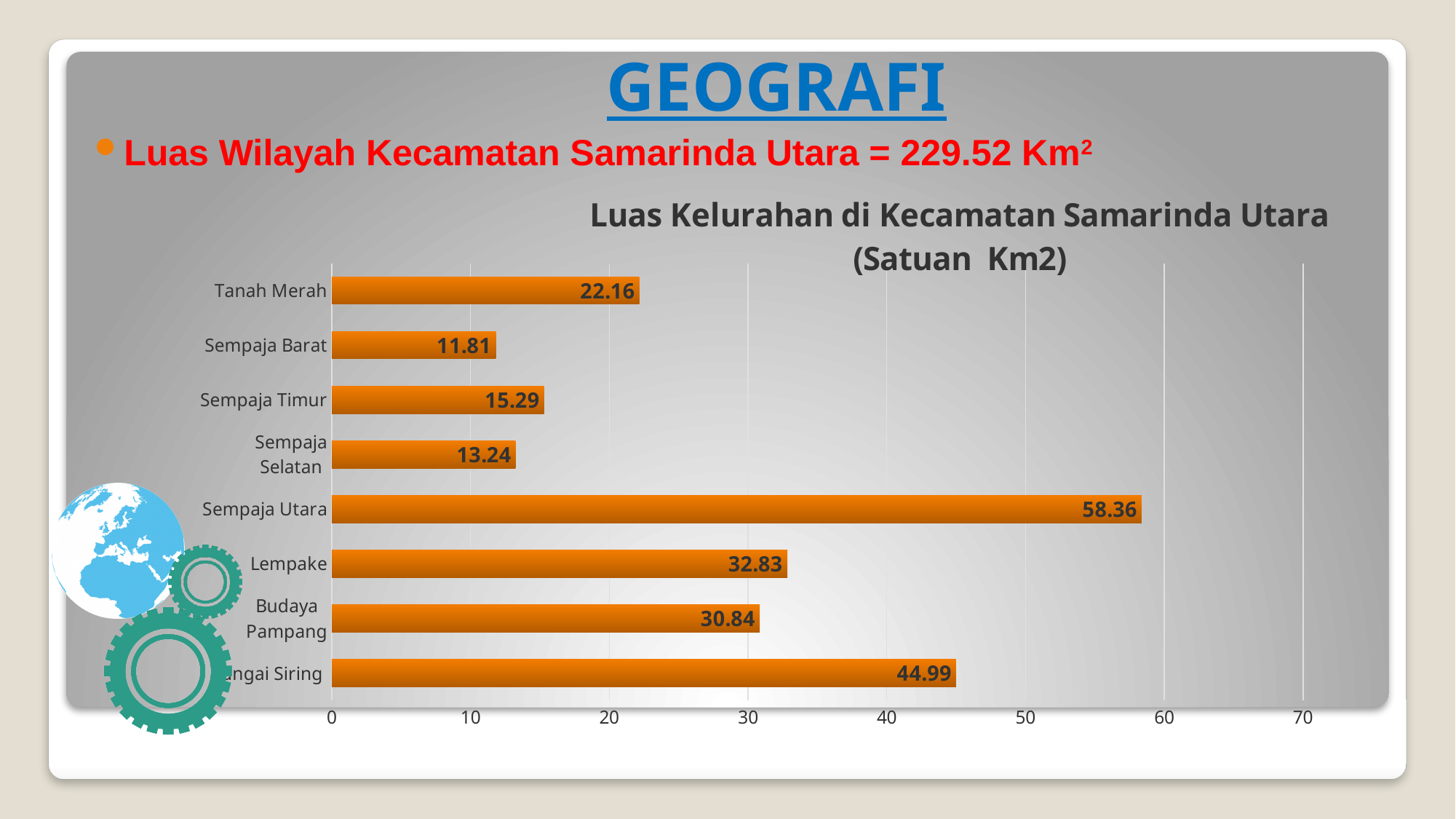
Which kelurahan has the smallest area in the chart? Sempaja Barat What is the value for Lempake? 32.83 Which is larger, the value for Sempaja Timur or the value for Sempaja Selatan? Sempaja Timur Is the value for Budaya Pampang greater or less than 30? greater What is the difference between the values for Lempake and Budaya Pampang? 1.99 What kind of chart is shown on the slide? Bar chart What is the value for Sempaja Selatan? 13.24 What is the value for Sempaja Utara? 58.36 Which kelurahan has the largest area in the chart? Sempaja Utara How many kelurahan (bars) are shown in the chart? 8 What unit is stated in the chart title? Km2 What is the value for Tanah Merah? 22.16